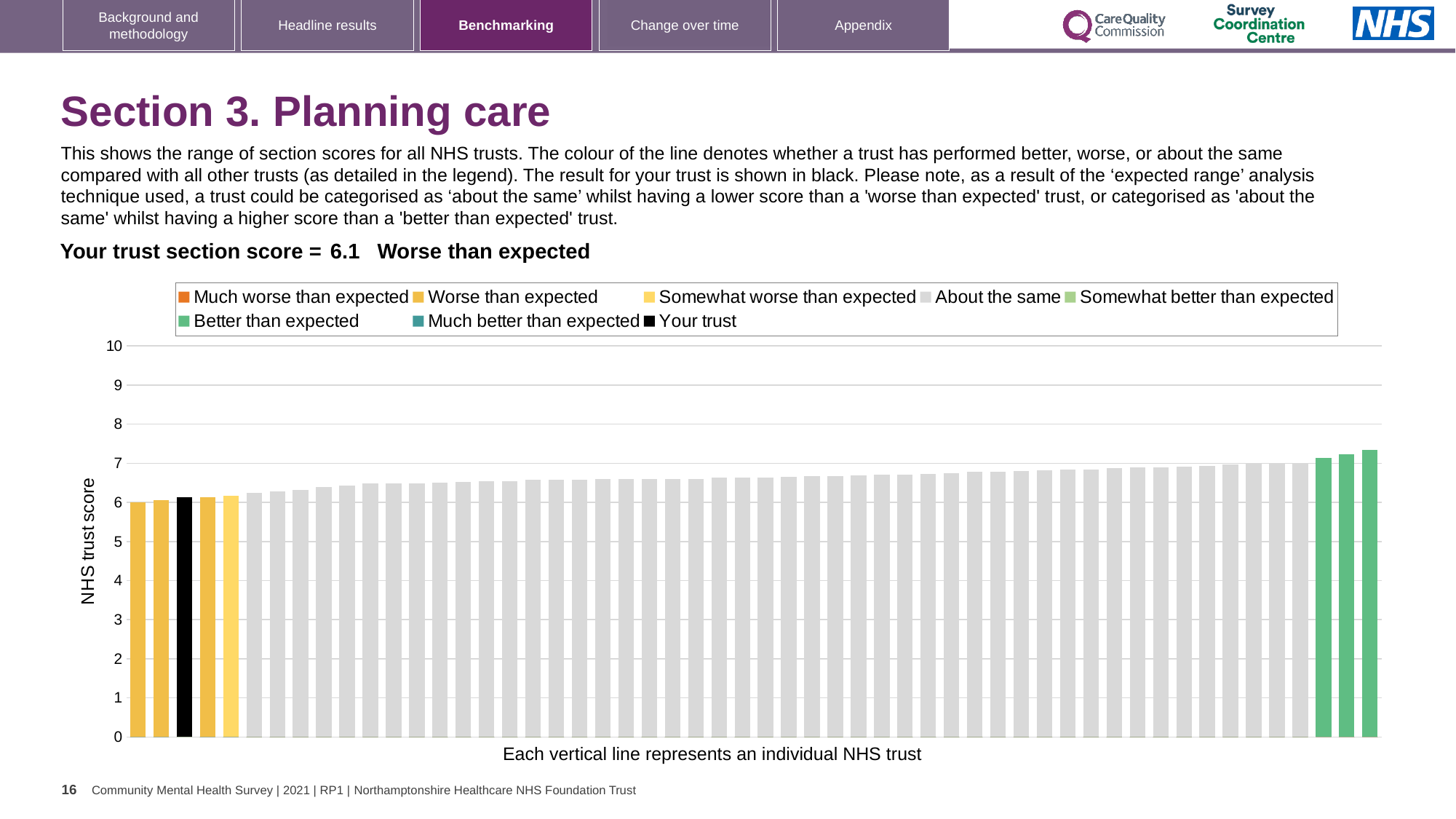
Is the value of the rightmost bar greater or less than 7? greater How many entries does the chart legend list? 8 Is the value of the black 'Your trust' bar greater or less than 7? less Which performance category is your trust placed in for this section? Worse than expected How many green bars are there in the chart? 3 Which bar is the highest in the chart? the rightmost bar Is the value of the leftmost bar greater or less than 5? greater What is the section score for your trust, as printed on the slide? 6.1 Which bar is the lowest in the chart? the leftmost bar Do the bar values rise or fall from left to right along the x axis? rise What kind of chart is shown on the slide? bar chart What is the label on the vertical axis of the chart? NHS trust score